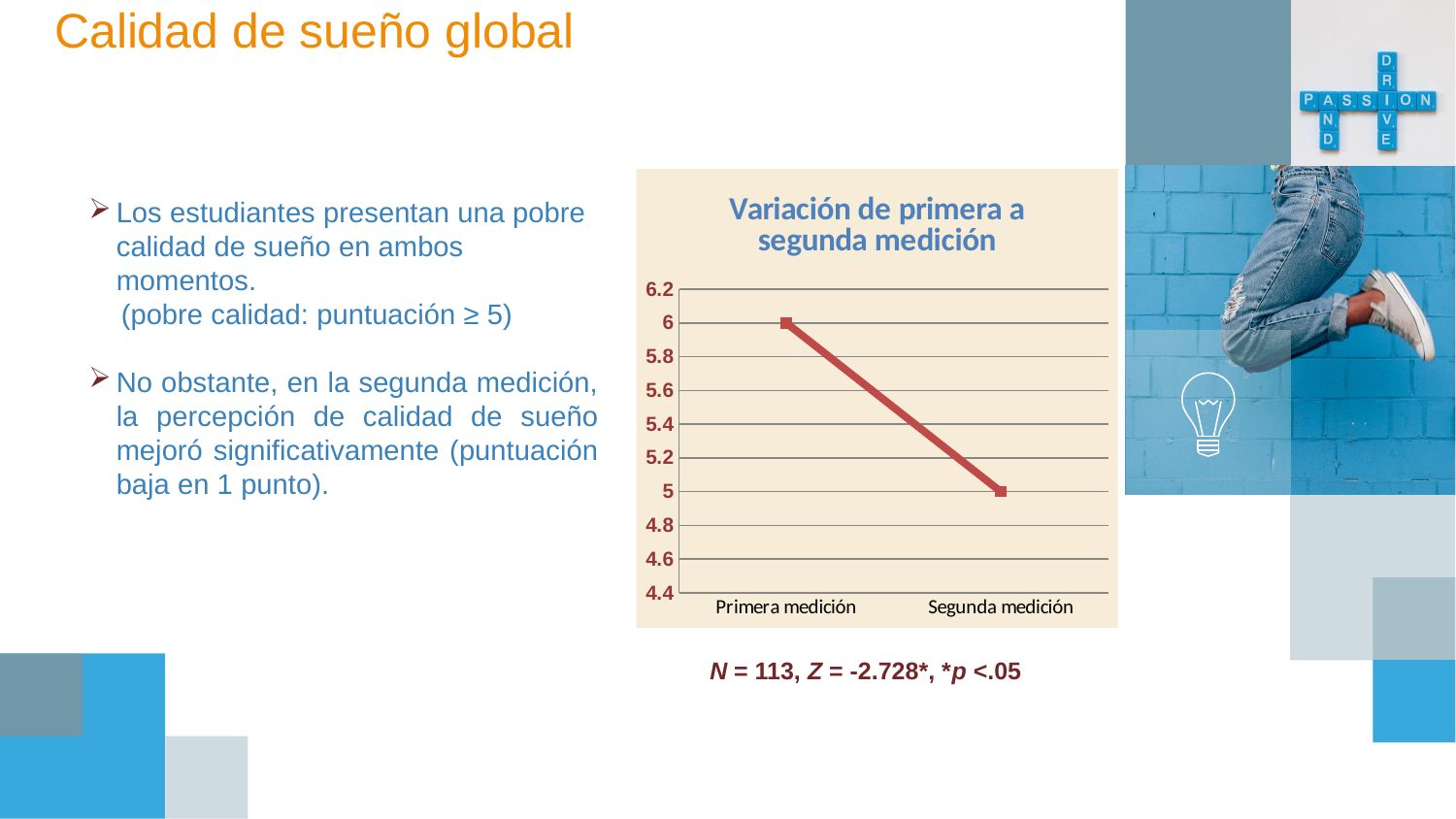
Which measurement has the higher value, Primera medición or Segunda medición? Primera medición What is the value for Segunda medición? 5 Which category has the highest value? Primera medición How many data points are plotted on the chart? 2 Do the values rise or fall from Primera medición to Segunda medición? fall Is the value for Segunda medición greater or less than 5.4? less Which category has the lowest value? Segunda medición What is the difference between the value for Primera medición and the value for Segunda medición? 1 What is the lowest value shown on the vertical axis? 4.4 What is the title of the chart? Variación de primera a segunda medición What is the value for Primera medición? 6 What type of chart is shown on the slide? line chart